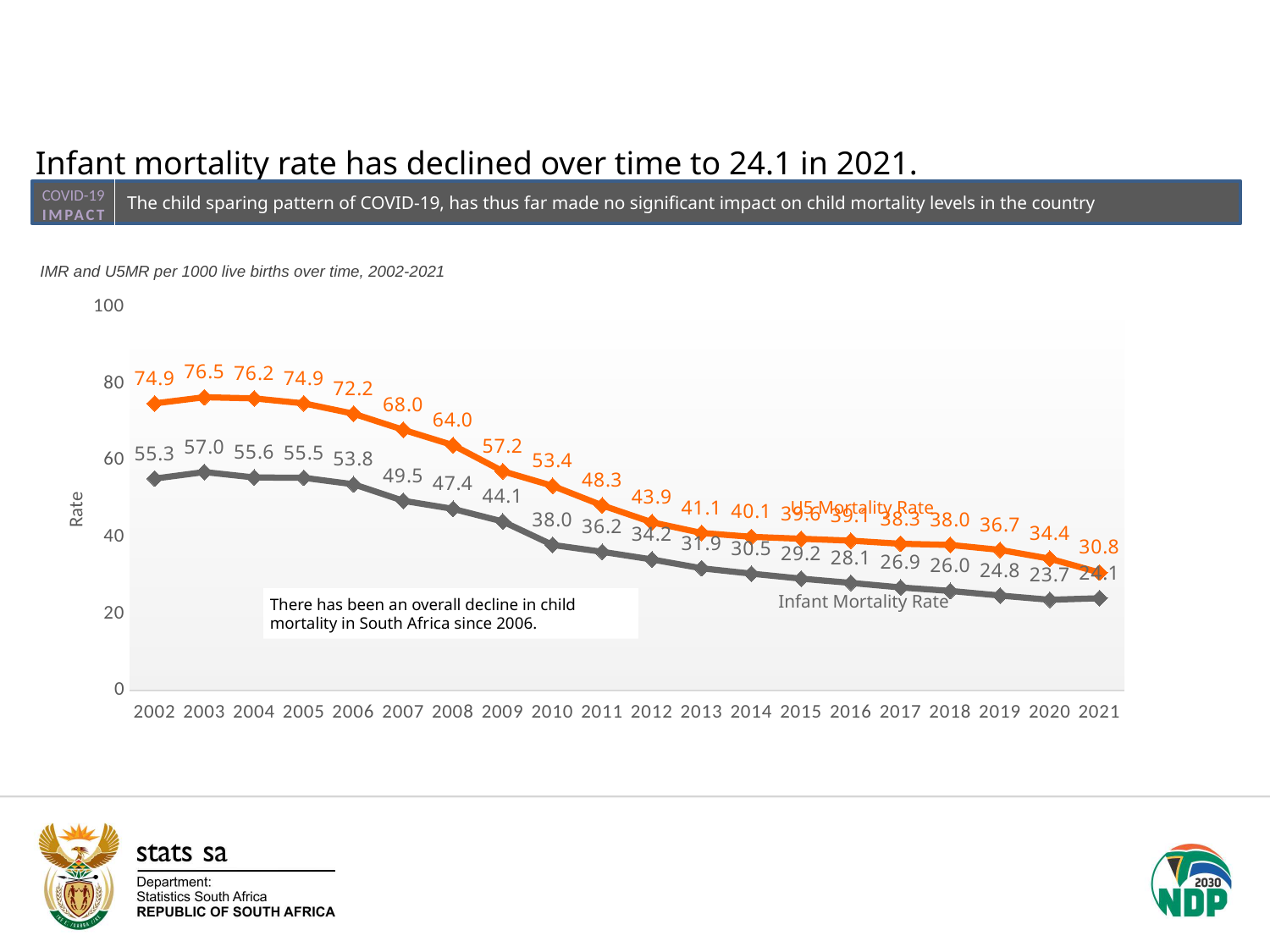
By how much did the Under-5 Mortality Rate fall from 2002 to 2021? 44.1 What type of chart is shown on the slide? Line chart Which was higher in 2012, the Under-5 Mortality Rate or the Infant Mortality Rate? Under-5 Mortality Rate In which year was the Under-5 Mortality Rate highest? 2003 What was the Under-5 Mortality Rate in 2021? 30.8 What was the Infant Mortality Rate in 2020? 23.7 In which year was the Infant Mortality Rate highest? 2003 How many series are plotted on the chart? 2 What was the Under-5 Mortality Rate in 2003? 76.5 How many years are shown on the x axis? 20 What is the difference between the Under-5 Mortality Rate and the Infant Mortality Rate in 2008? 16.6 What was the Infant Mortality Rate in 2010? 38.0